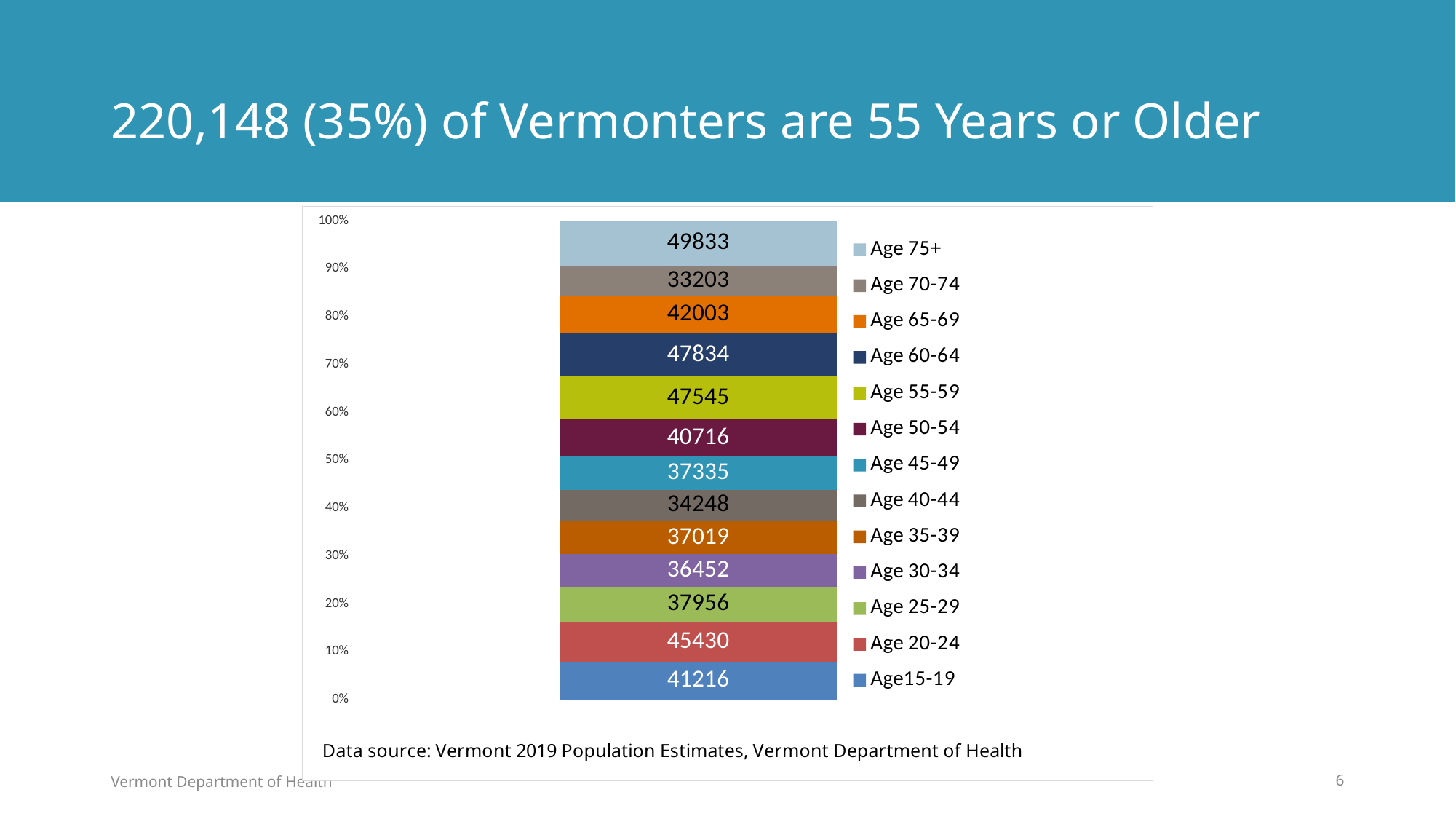
What is the difference between the values for Age 20-24 and Age 15-19? 4214 Which is larger, the value for Age 65-69 or the value for Age 70-74? Age 65-69 What is the difference between the values for Age 75+ and Age 70-74? 16630 Which is larger, the value for Age 20-24 or the value for Age 25-29? Age 20-24 What is the total of all segments in the stacked bar? 530790 Which age group has the highest value in the stacked bar? Age 75+ What is the value shown for Age 40-44? 34248 How many age groups does the legend list? 13 What is the value shown for Age 15-19? 41216 What is the value shown for Age 75+? 49833 What kind of chart is shown on the slide? Stacked bar chart Which age group has the lowest value in the stacked bar? Age 70-74